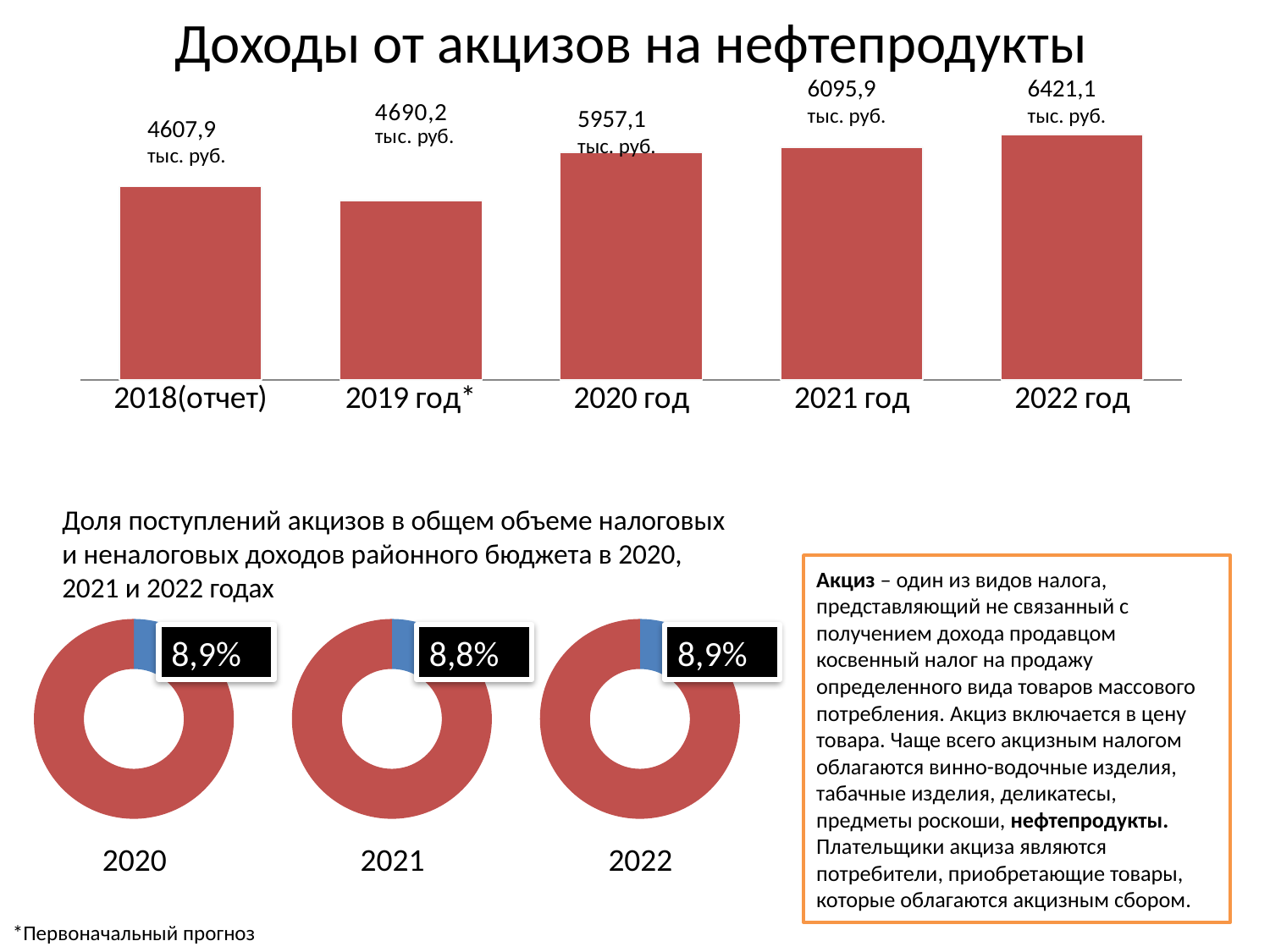
In the bar chart 'Доходы от акцизов на нефтепродукты', what is the value for 2022 год? 6421,1 тыс. руб. What kind of chart is the top chart 'Доходы от акцизов на нефтепродукты'? Bar chart In the donut charts at the bottom of the slide, what share is shown for 2020? 8,9% How many donut charts are shown at the bottom of the slide? 3 How many bars are in the bar chart 'Доходы от акцизов на нефтепродукты'? 5 In the bar chart 'Доходы от акцизов на нефтепродукты', which is larger: the value for 2021 год or the value for 2020 год? 2021 год In the bar chart 'Доходы от акцизов на нефтепродукты', which year has the highest value? 2022 год In the bar chart 'Доходы от акцизов на нефтепродукты', do the values rise or fall from 2020 год to 2022 год? Rise In the bar chart 'Доходы от акцизов на нефтепродукты', what is the difference between the values for 2022 год and 2021 год? 325,2 тыс. руб. In the donut charts at the bottom of the slide, what share is shown for 2021? 8,8% In the bar chart 'Доходы от акцизов на нефтепродукты', what is the value for 2018(отчет)? 4607,9 тыс. руб. In the bar chart 'Доходы от акцизов на нефтепродукты', what is the value for 2020 год? 5957,1 тыс. руб.